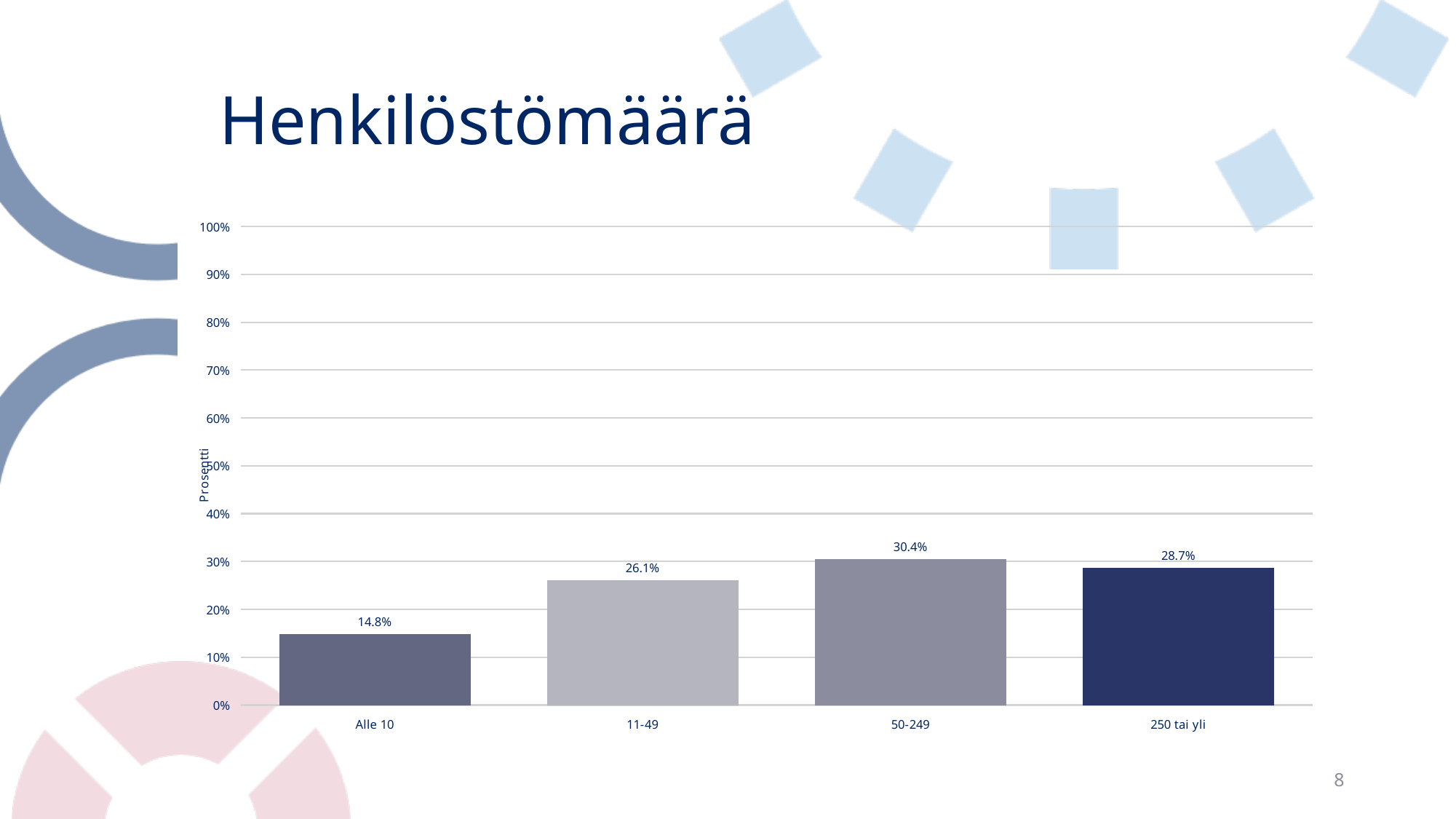
What is the value for the "50-249" category? 30.4% What is the title of the slide? Henkilöstömäärä What is the value for the "Alle 10" category? 14.8% Which category has the highest value? 50-249 What is the value for the "250 tai yli" category? 28.7% Is the value for "11-49" greater or less than 30%? less Which category has the lowest value? Alle 10 Which is larger, the value for "11-49" or the value for "250 tai yli"? 250 tai yli How many categories are shown on the x axis? 4 What kind of chart is shown on the slide? bar chart What is the value for the "11-49" category? 26.1% What is the difference between the values for "50-249" and "Alle 10"? 15.6%